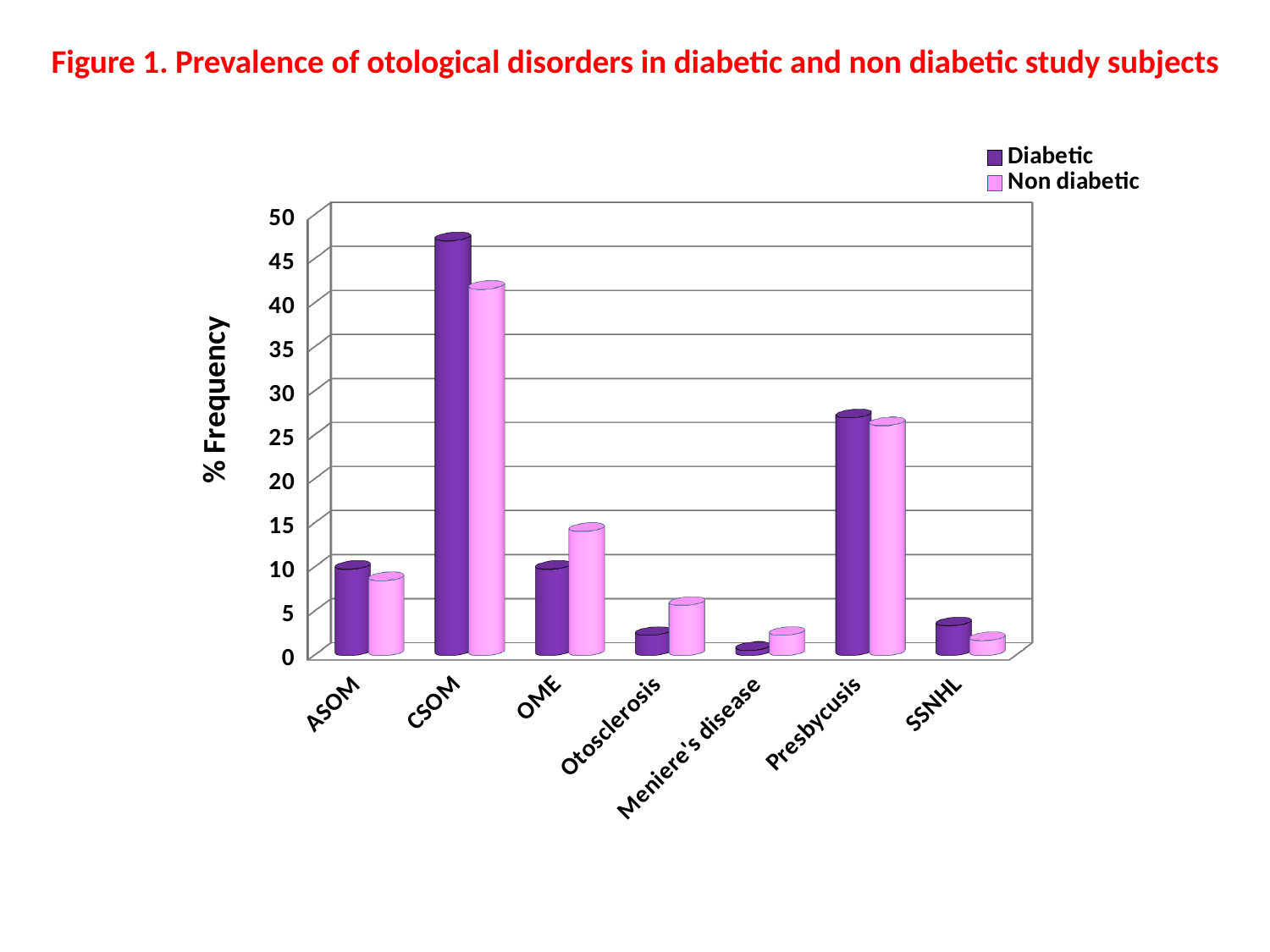
How many otological disorder categories are shown on the x axis? 7 For CSOM, which series has the larger value, Diabetic or Non diabetic? Diabetic For Otosclerosis, which series has the larger value, Diabetic or Non diabetic? Non diabetic Which category has the highest value for the Diabetic series? CSOM Is the Diabetic value for Presbycusis greater or less than 20? greater How many series does the legend list? 2 Is the Diabetic value for CSOM greater or less than 40? greater For OME, which series has the larger value, Diabetic or Non diabetic? Non diabetic What is the title of the y axis? % Frequency Which category has the highest value for the Non diabetic series? CSOM What kind of chart is shown on the slide? bar chart Which category has the lowest value for the Diabetic series? Meniere's disease